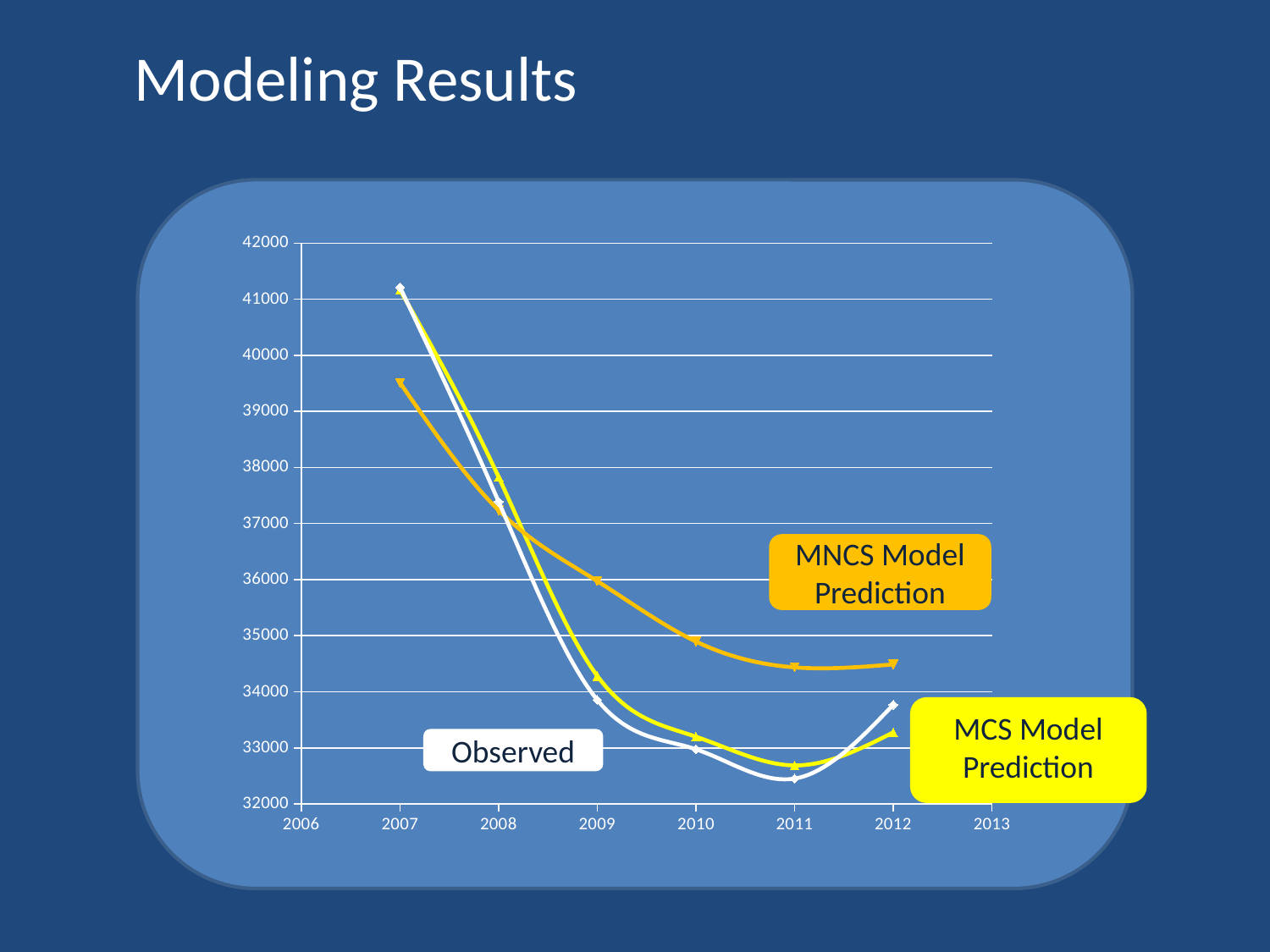
Is the MNCS Model Prediction value for 2007 greater or less than 40000? less Is the Observed value for 2007 greater or less than 41000? greater In 2011, which is higher: the MNCS Model Prediction or the Observed value? MNCS Model Prediction How many data points does the Observed series have? 6 In which year does the Observed series reach its lowest value? 2011 Is the MNCS Model Prediction value for 2009 greater or less than 37000? less Does the Observed series rise or fall from 2007 to 2011? fall What kind of chart is shown on the slide? line chart How many series are plotted on the chart? 3 In which year is the MNCS Model Prediction highest? 2007